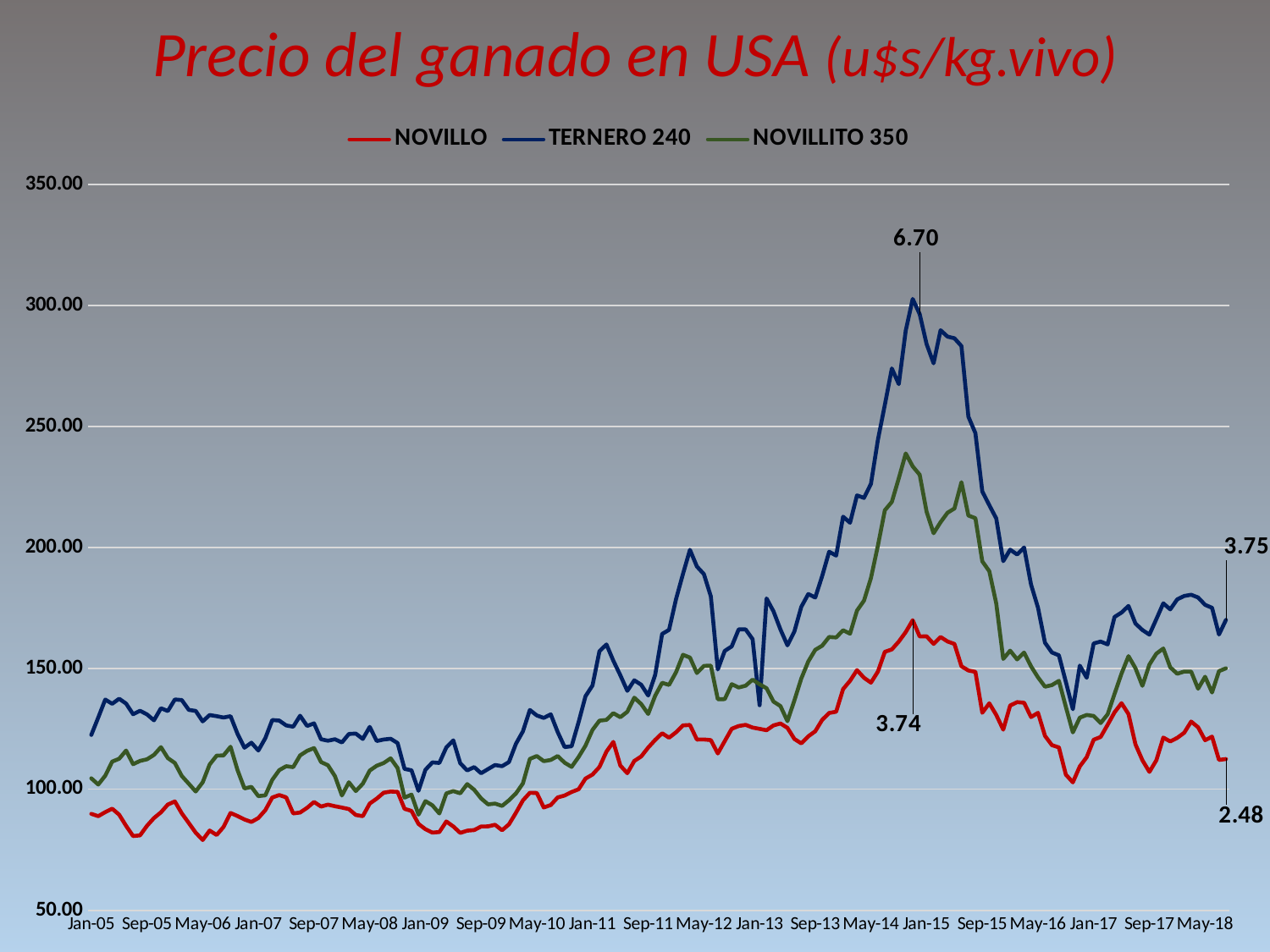
What kind of chart is shown on the slide? line chart What data label is shown at the end of the NOVILLO line (May-18)? 2.48 What data label is shown at the end of the TERNERO 240 line (May-18)? 3.75 What is the title of the chart? Precio del ganado en USA (u$s/kg.vivo) Which series stays lowest across the whole period? NOVILLO What data label is shown at the peak of the NOVILLO line around Jan-15? 3.74 Is the value for TERNERO 240 at its Jan-15 peak greater or less than 250.00? greater Does the NOVILLO line rise or fall from Jan-15 to May-18? fall What is the difference between the end-of-series labels for TERNERO 240 (3.75) and NOVILLO (2.48)? 1.27 How many series does the legend list? 3 Which series reaches the highest value on the chart? TERNERO 240 What data label is shown at the peak of the TERNERO 240 line around Jan-15? 6.70